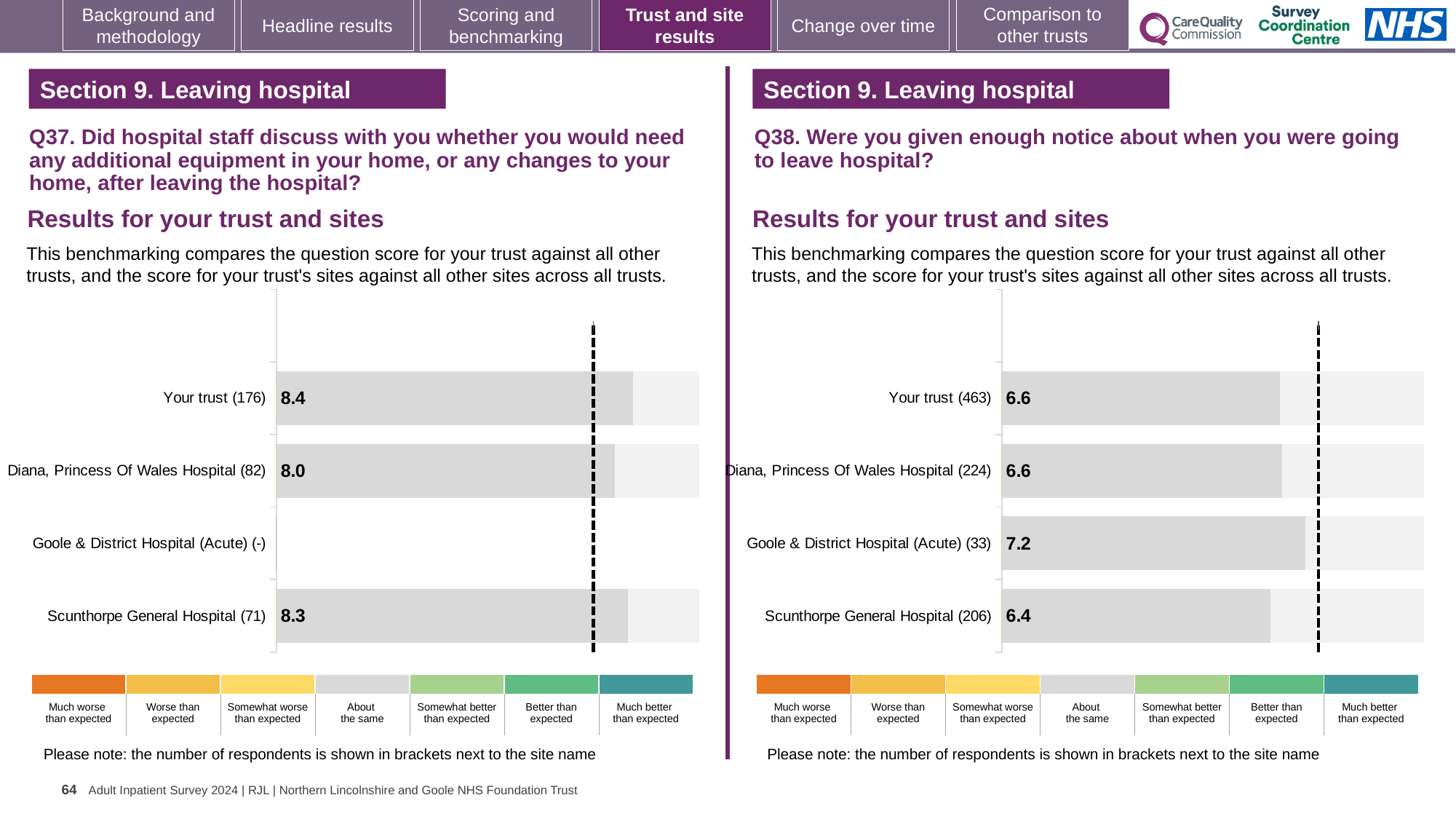
In the Q37 chart on the left, what is the score for Scunthorpe General Hospital? 8.3 In the Q37 chart on the left, what is the difference between the scores for Your trust and Diana, Princess Of Wales Hospital? 0.4 In the Q37 chart on the left, which site has the lowest score shown? Diana, Princess Of Wales Hospital In the Q37 chart on the left, what is the score for Your trust? 8.4 In the Q38 chart on the right, which site has the lowest score? Scunthorpe General Hospital In the Q38 chart on the right, what is the score for Goole & District Hospital (Acute)? 7.2 In the Q38 chart on the right, what is the difference between the scores for Goole & District Hospital (Acute) and Scunthorpe General Hospital? 0.8 In the Q38 chart on the right, how many respondents are shown in brackets for Your trust? 463 What kind of chart is used in the Q37 chart on the left? Bar chart In the Q38 chart on the right, which site has the highest score? Goole & District Hospital (Acute) In the Q37 chart on the left, what is the score for Diana, Princess Of Wales Hospital? 8.0 In the Q38 chart on the right, what is the score for Scunthorpe General Hospital? 6.4